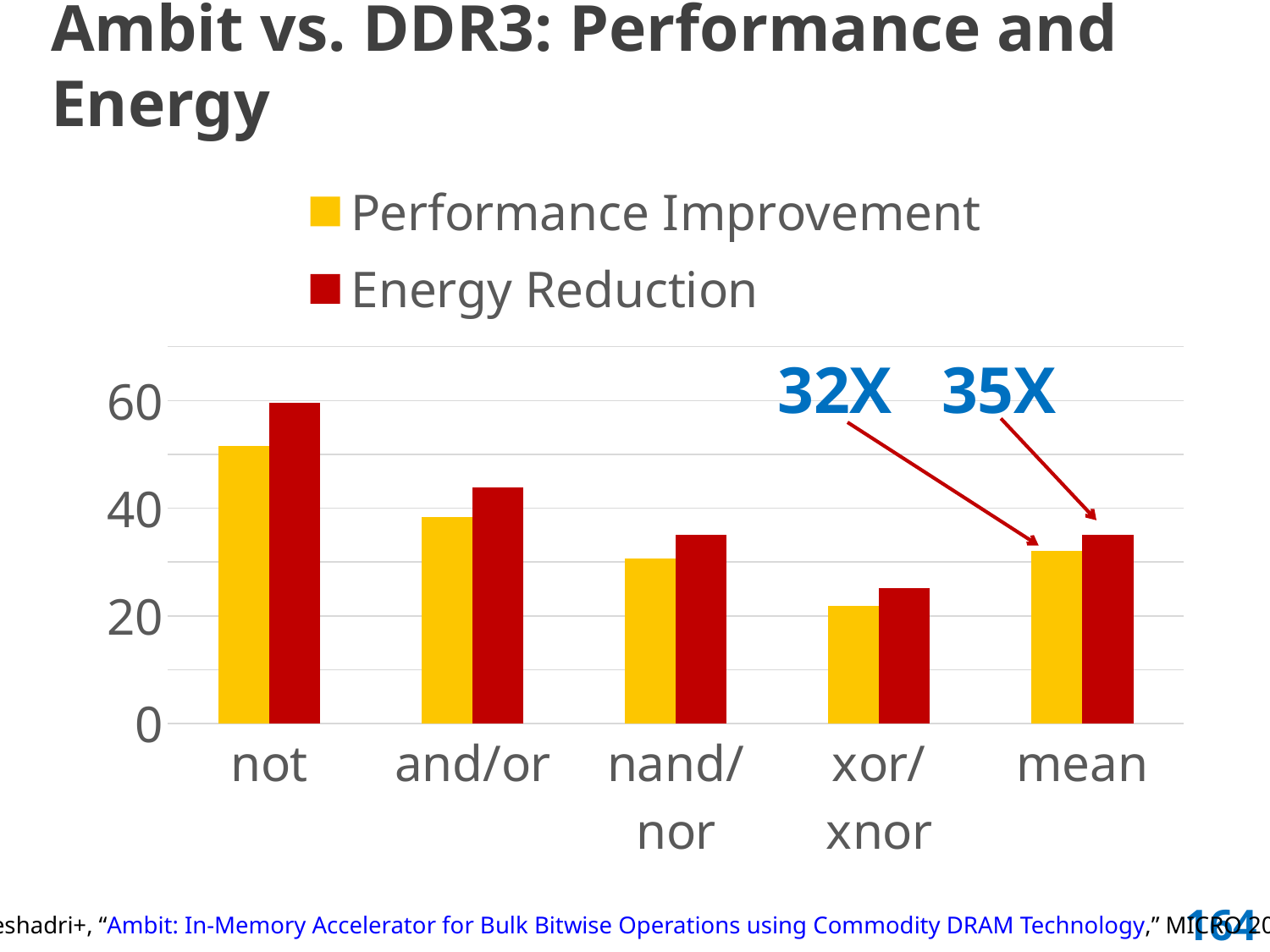
Is the Performance Improvement value for xor/xnor greater or less than 40? less What is the difference between the Energy Reduction and Performance Improvement values for the mean category? 3X How many series does the legend list? 2 Which category has the highest Energy Reduction? not Which category has the lowest Performance Improvement? xor/xnor Is the Energy Reduction value for not greater or less than 40? greater Does Performance Improvement rise or fall going from not to xor/xnor along the x axis? fall How many categories are shown on the x axis? 5 What is the Performance Improvement value for the mean category? 32X What is the Energy Reduction value for the mean category? 35X What kind of chart is shown on the slide? bar chart For the not category, which is larger: Performance Improvement or Energy Reduction? Energy Reduction